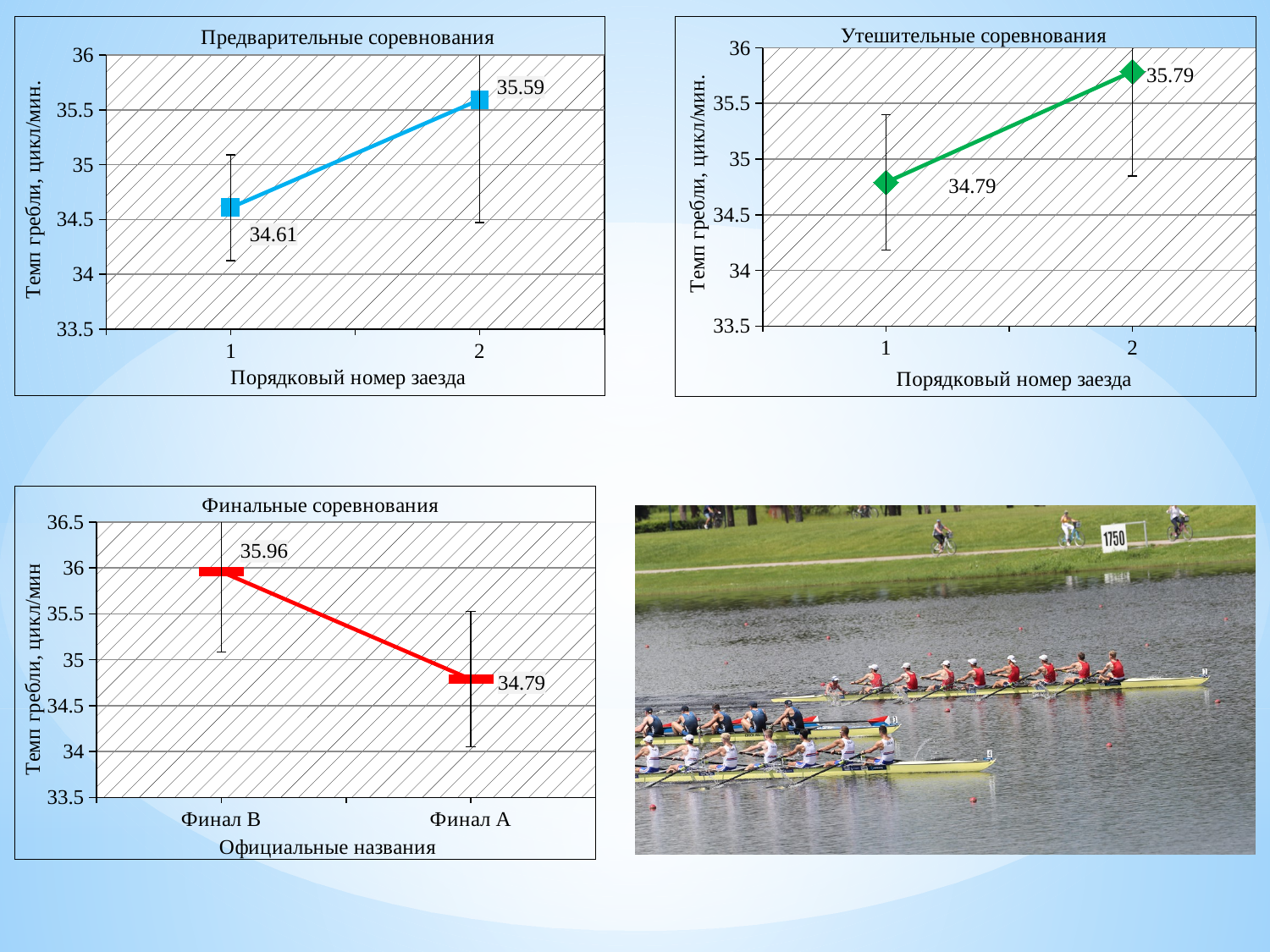
In the chart titled 'Финальные соревнования', which category has the higher value, Финал B or Финал A? Финал B In the chart titled 'Финальные соревнования', what is the difference between the values for Финал B and Финал A? 1.17 What kind of chart is the chart titled 'Утешительные соревнования'? line chart In the chart titled 'Утешительные соревнования', what is the value for race number 2? 35.79 In the chart titled 'Финальные соревнования', what is the value for Финал B? 35.96 In the chart titled 'Предварительные соревнования', what is the value for race number 1? 34.61 In the chart titled 'Финальные соревнования', do the values rise or fall along the x axis? fall In the chart titled 'Финальные соревнования', what is the value for Финал A? 34.79 In the chart titled 'Предварительные соревнования', what is the difference between the values for race 2 and race 1? 0.98 In the chart titled 'Предварительные соревнования', what is the value for race number 2? 35.59 In the chart titled 'Утешительные соревнования', what is the value for race number 1? 34.79 In the chart titled 'Утешительные соревнования', do the values rise or fall from race 1 to race 2? rise